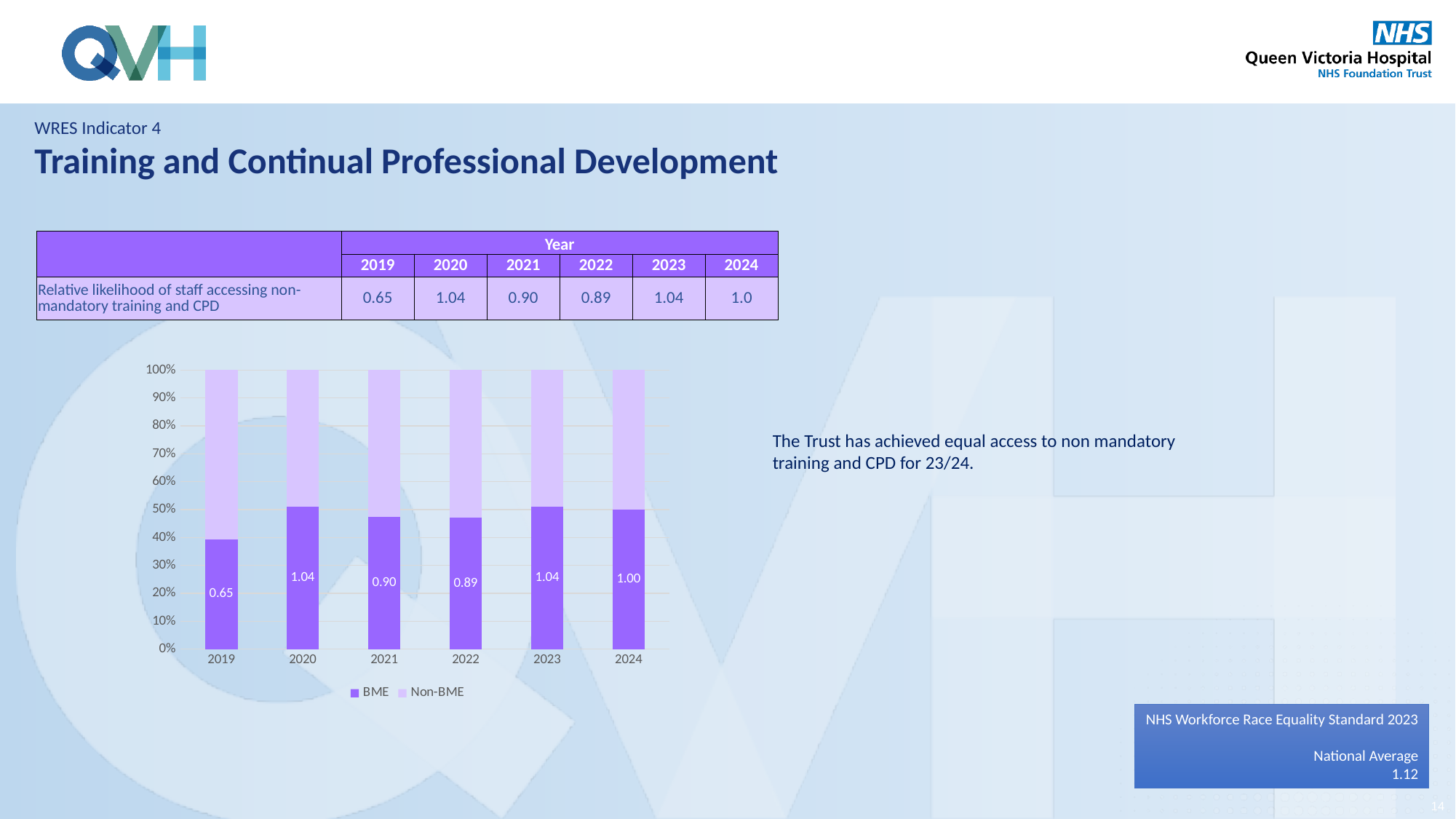
Which year has the lowest data label on its BME bar? 2019 How many years are shown along the x axis of the chart? 6 What are the two series named in the chart legend? BME and Non-BME Is the BME share of the 2019 bar greater or less than 50%? less What data label is printed on the BME bar for 2019? 0.65 What kind of chart is shown on the slide? bar chart How many series does the chart legend list? 2 What is the difference between the BME data labels for 2020 and 2019? 0.39 Which is larger, the BME data label for 2021 or for 2023? 2023 What data label is printed on the BME bar for 2024? 1.00 Does the BME data label rise or fall from 2019 to 2020? rise What data label is printed on the BME bar for 2022? 0.89